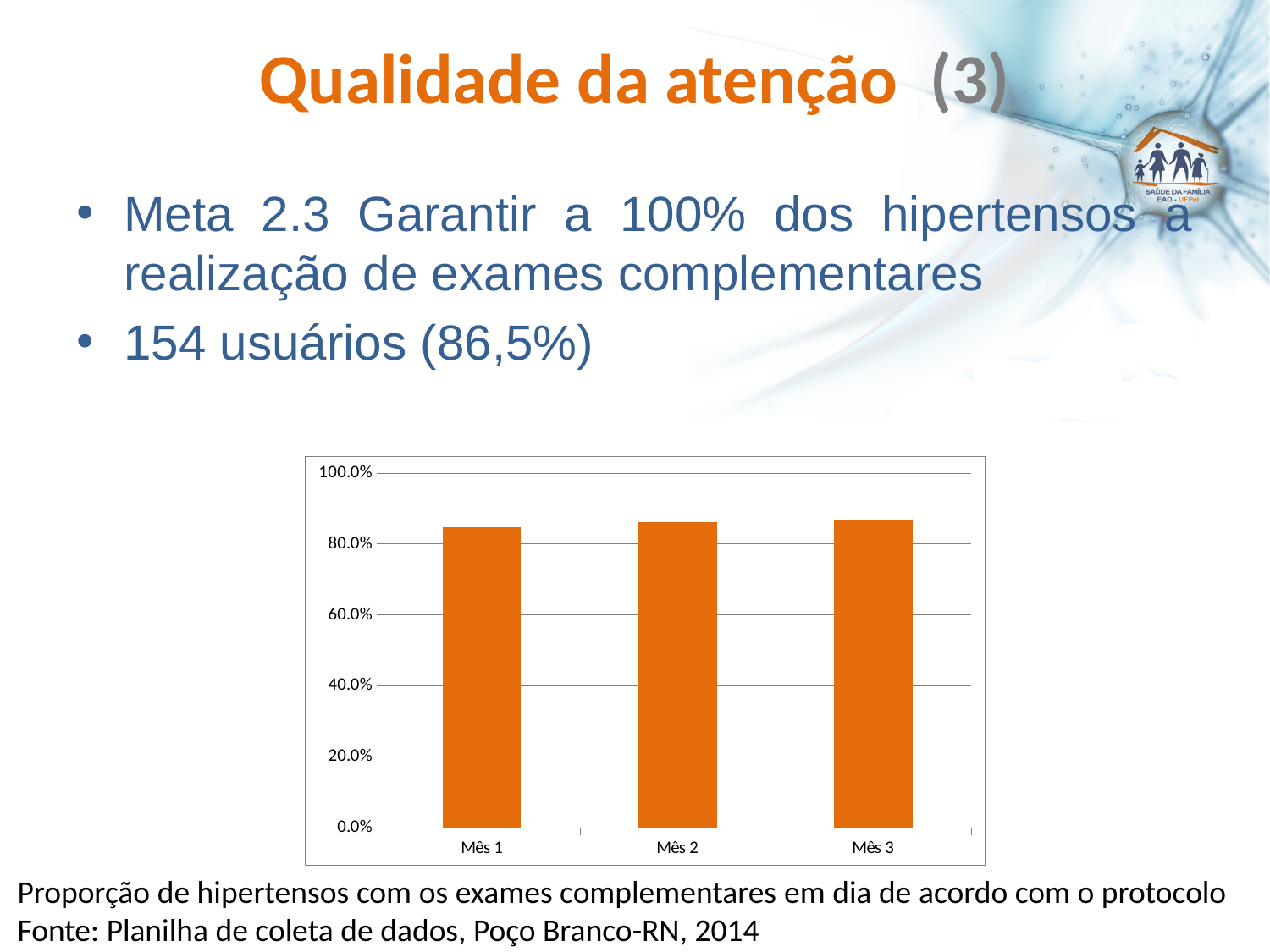
What kind of chart is shown on the slide? bar chart What is the highest value shown on the y axis of the chart? 100.0% Is the value for Mês 1 greater or less than 80.0%? greater Is the value for Mês 3 greater or less than 100.0%? less Is the value for Mês 3 greater or less than 80.0%? greater What is the label of the first category on the x axis? Mês 1 How many categories (months) are plotted on the chart? 3 What colour are the bars in the chart? orange Do the values rise or fall from Mês 1 to Mês 3? rise